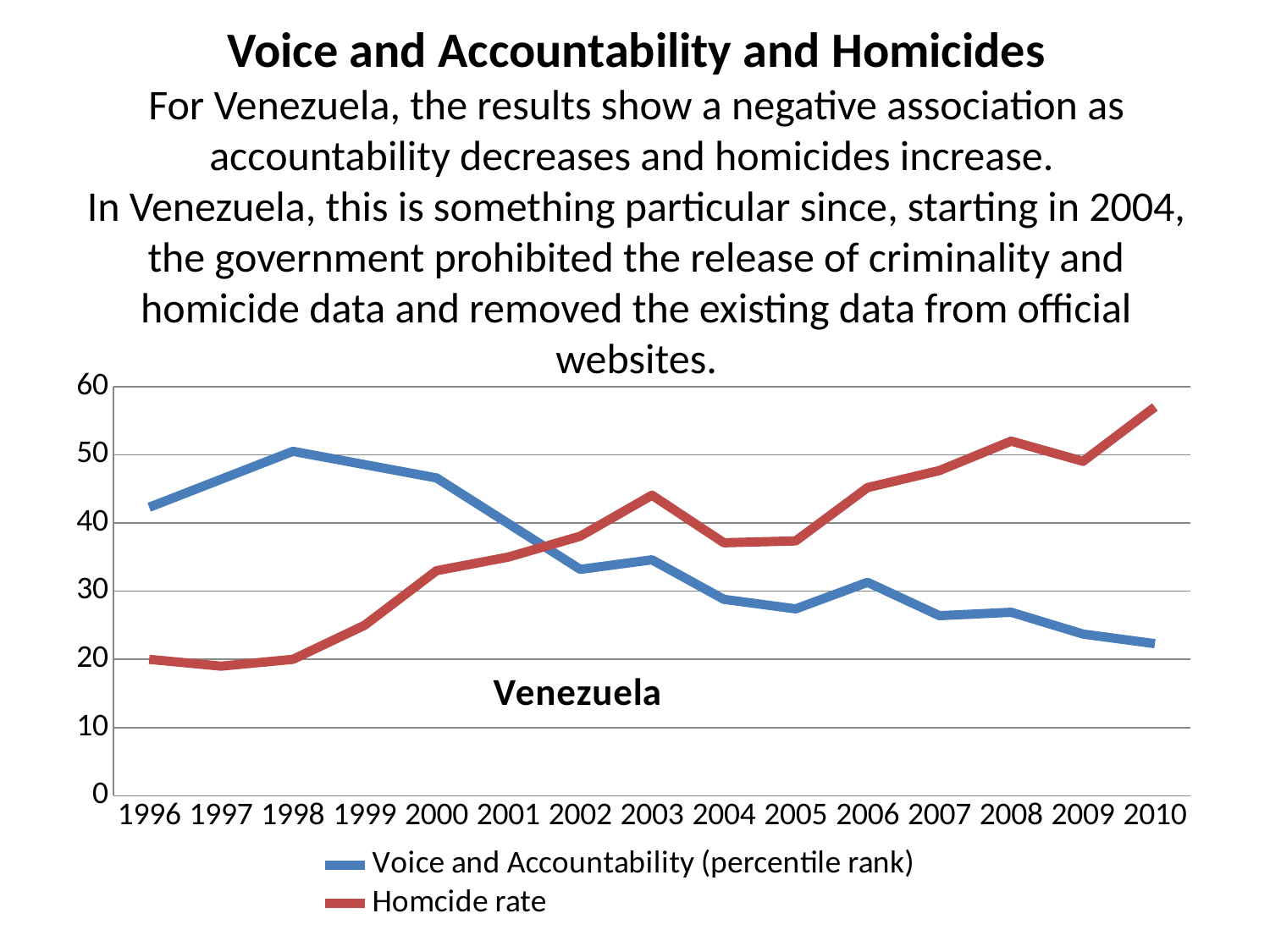
Does the Voice and Accountability (percentile rank) line rise or fall from 1998 to 2010? fall Is the Homicide rate value for 2010 greater or less than 50? greater How many years are shown along the x axis of the chart? 15 In which year is the Voice and Accountability (percentile rank) highest? 1998 Is the Voice and Accountability (percentile rank) value for 2010 greater or less than 30? less What kind of chart is shown on the slide? line chart Is the Homicide rate value for 1996 greater or less than 30? less How many series does the chart's legend list? 2 Does the Homicide rate line rise or fall overall from 1996 to 2010? rise What title is printed inside the chart's plot area? Venezuela In 1996, which series has the higher value, Voice and Accountability (percentile rank) or Homicide rate? Voice and Accountability (percentile rank) In which year is the Homicide rate highest? 2010